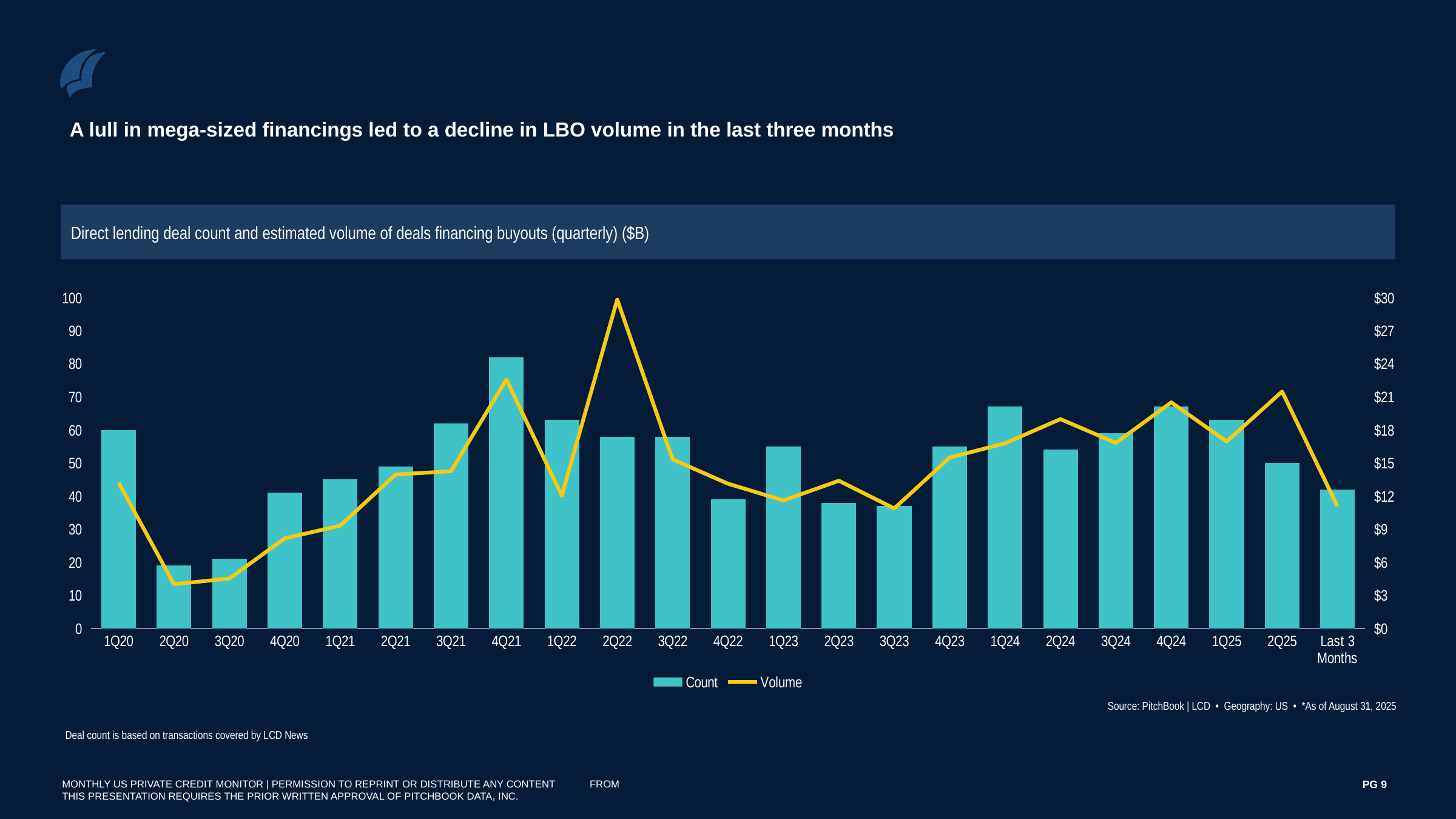
How many series does the legend list? 2 Does the Volume line rise or fall from 2Q25 to Last 3 Months? Fall Is the Count value for 3Q23 greater or less than 40? less Which quarter has the lowest deal count bar? 2Q20 In which quarter does the Volume line reach its peak? 2Q22 Is the Count value for 1Q24 greater or less than 60? greater What kind of chart is shown on the slide? Combined bar and line chart Which has the larger deal count, 4Q21 or 1Q22? 4Q21 How many categories are shown on the x axis? 23 Which series is plotted as a yellow line? Volume Is the Volume value for 2Q22 greater or less than $27? greater Which quarter has the highest deal count bar? 4Q21